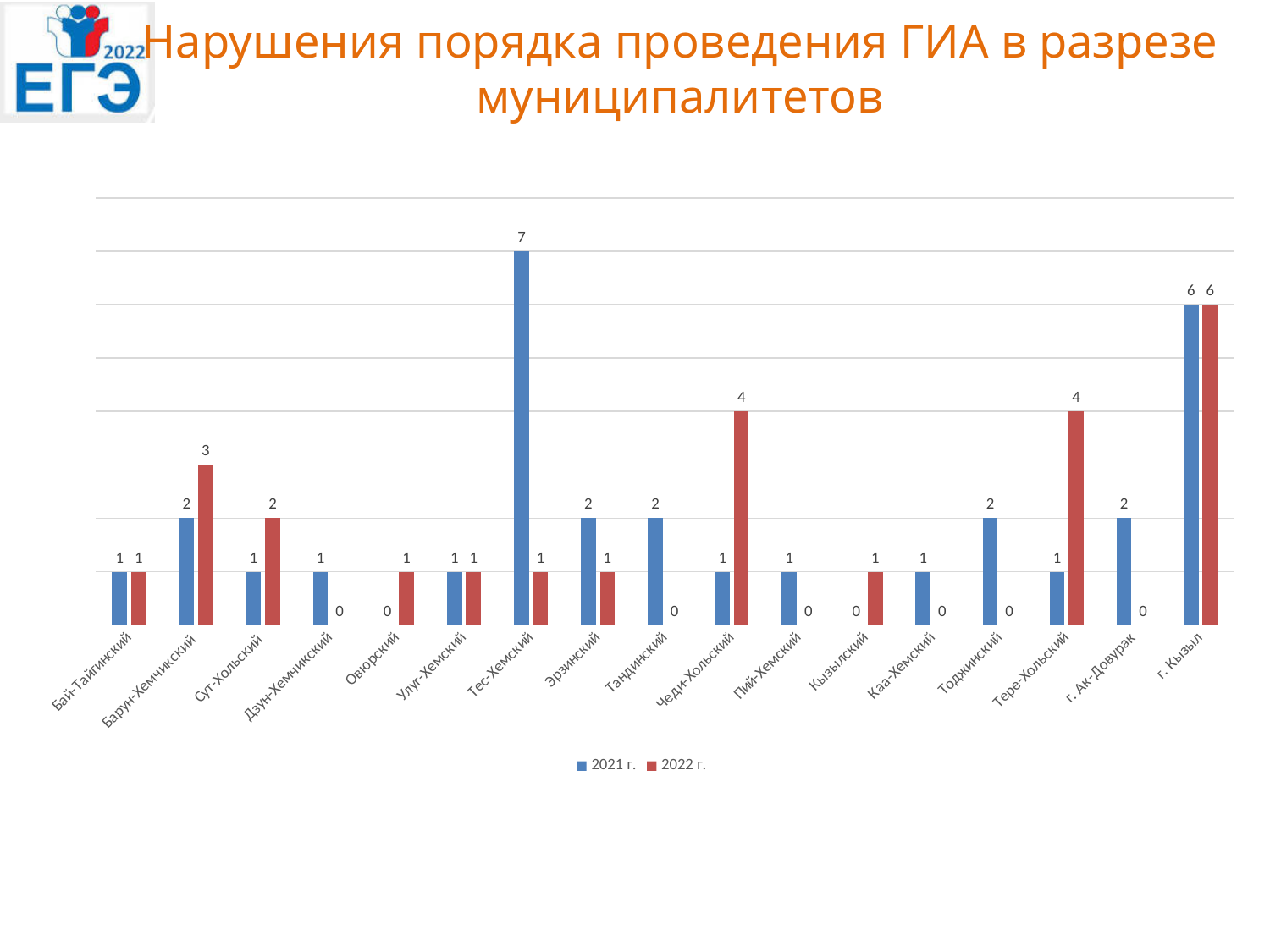
What is the difference between the 2022 г. and 2021 г. values for Тере-Хольский? 3 What is the value for Тес-Хемский in the 2021 г. series? 7 Which municipality has the highest value in the 2022 г. series? г. Кызыл What is the difference between the 2021 г. and 2022 г. values for Тес-Хемский? 6 What is the value for г. Ак-Довурак in the 2021 г. series? 2 What is the value for Чеди-Хольский in the 2022 г. series? 4 Which municipality has the highest value in the 2021 г. series? Тес-Хемский What kind of chart is shown on the slide? Bar chart How many municipalities are shown on the x axis? 17 Which is larger for Эрзинский: the 2021 г. value or the 2022 г. value? 2021 г. What is the value for Барун-Хемчикский in the 2022 г. series? 3 How many series does the legend list? 2